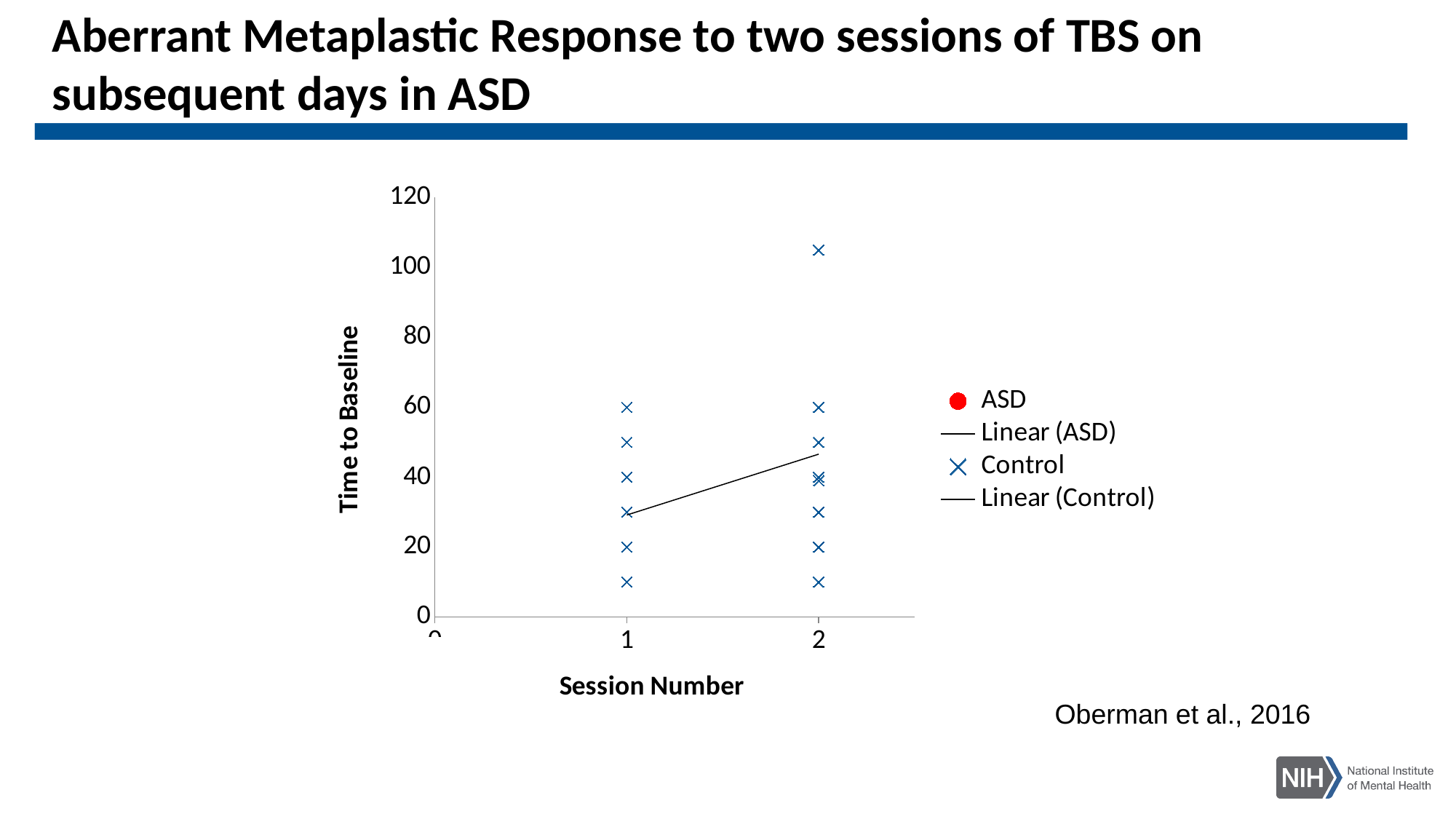
How many session numbers have data points plotted on the chart? 2 Is the highest Control point at session 2 greater or less than 100? greater Is the highest Control point at session 1 greater or less than 40? greater What is the label of the vertical axis? Time to Baseline Is the lowest Control point at session 1 greater or less than 20? less What is the maximum value shown on the vertical axis? 120 Which session has the highest Control data point, session 1 or session 2? Session 2 What kind of chart is shown on the slide? Scatter chart How many entries does the chart's legend list? 4 What is the label of the horizontal axis? Session Number Does the Linear (Control) trend line rise or fall from session 1 to session 2? Rise